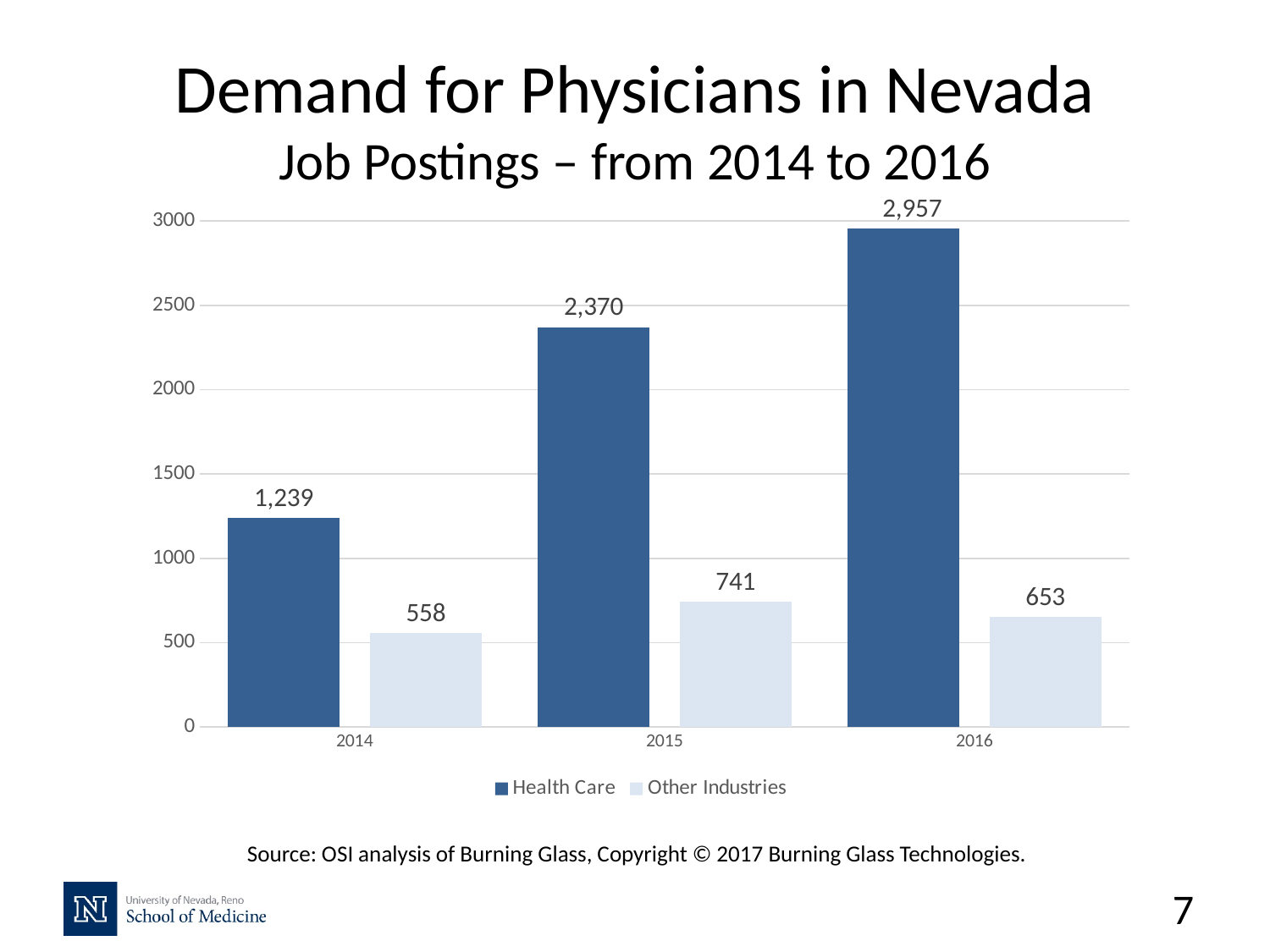
How many years are shown on the x axis? 3 What is the value for Other Industries in 2014? 558 Is the value for Other Industries in 2015 greater or less than 500? greater What is the value for Health Care in 2015? 2,370 Do the Health Care values rise or fall from 2014 to 2016? rise What kind of chart is shown? bar chart In which year is the Health Care value highest? 2016 Which is larger in 2016, Health Care or Other Industries? Health Care What is the difference between the Health Care and Other Industries values in 2015? 1,629 How many series does the legend list? 2 In which year is the Other Industries value lowest? 2014 What is the value for Health Care in 2016? 2,957